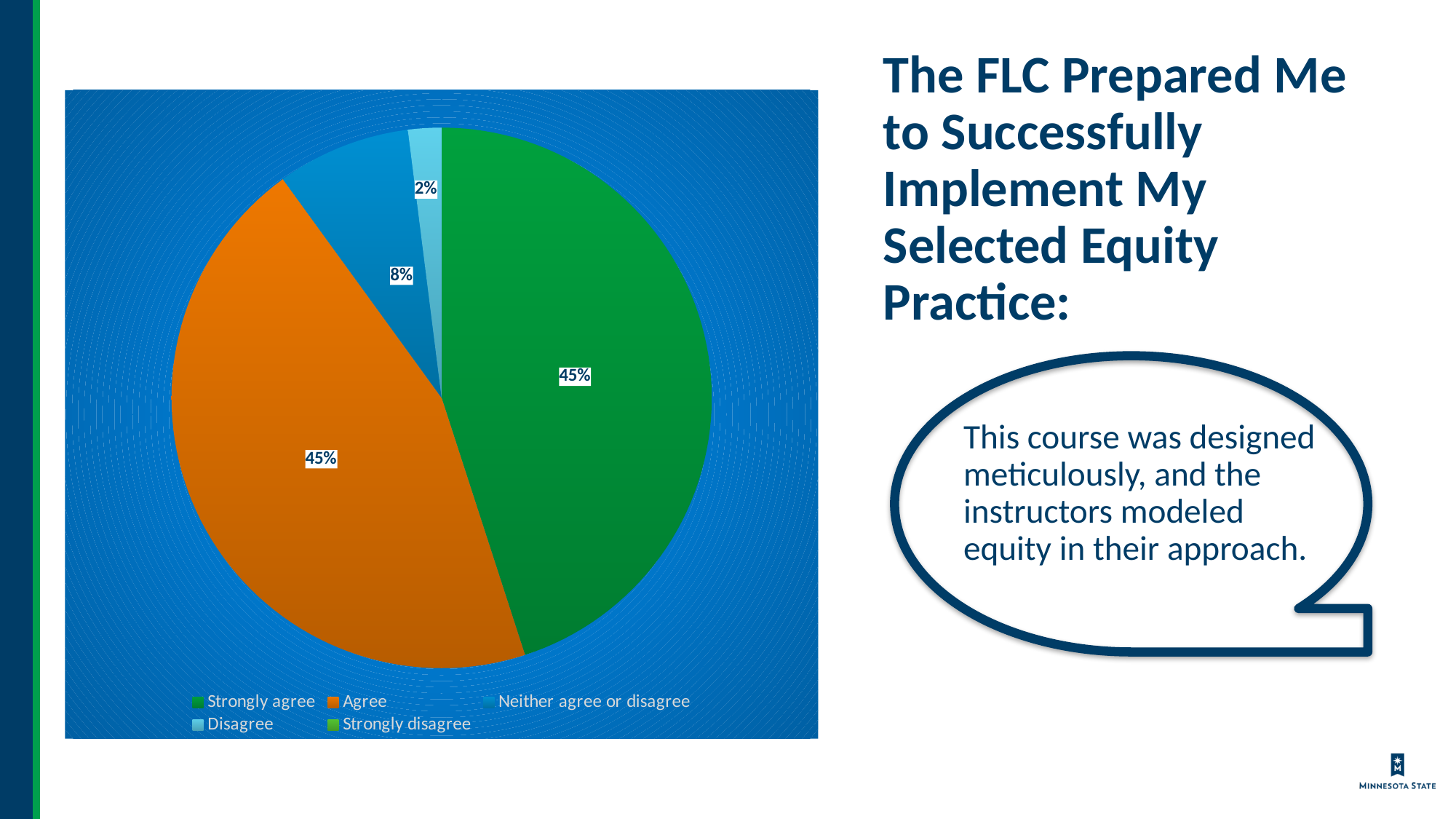
What colour is the Agree slice in the pie chart? orange What is the difference in percentage points between the Neither agree or disagree slice and the Disagree slice? 6 What percentage of respondents selected Disagree? 2% What percentage of respondents selected Neither agree or disagree? 8% What percentage of respondents selected Strongly agree? 45% What percentage of respondents selected Agree? 45% Which is larger, the Agree slice or the Neither agree or disagree slice? Agree What is the difference in percentage points between the Agree slice and the Neither agree or disagree slice? 37 How many entries does the legend of the pie chart list? 5 What is the combined share of the Strongly agree and Agree slices? 90% Which is larger, the Neither agree or disagree slice or the Disagree slice? Neither agree or disagree What kind of chart is shown on the slide? pie chart